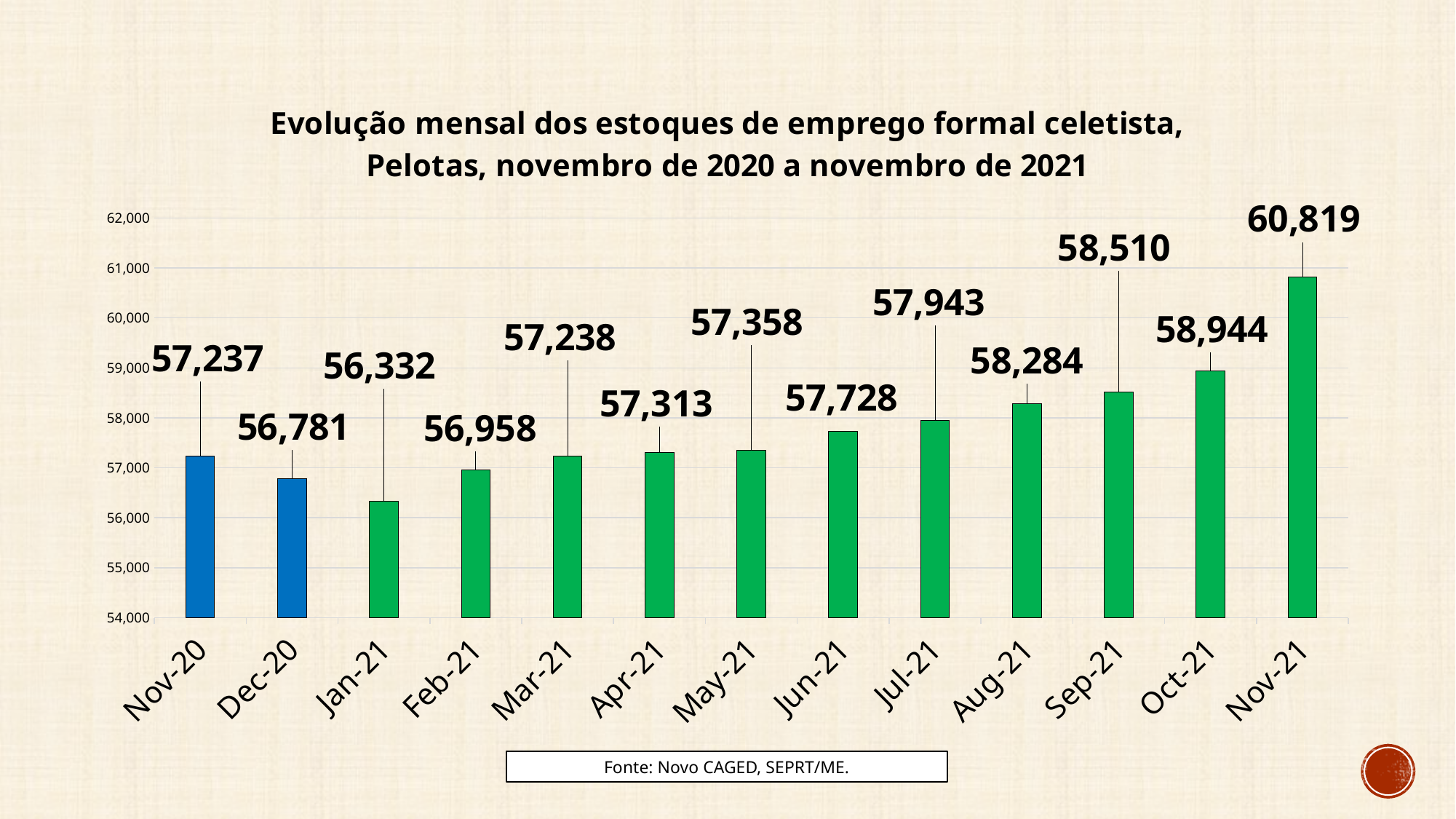
Which is larger, the value for Sep-21 or the value for Aug-21? Sep-21 How many months are shown on the x axis? 13 What is the value for Jun-21? 57,728 What is the value for Nov-21? 60,819 How many bars are coloured blue rather than green? 2 What kind of chart is shown on the slide? bar chart Which month has the lowest value? Jan-21 What is the difference between the values for Nov-21 and Oct-21? 1,875 Which month has the highest value? Nov-21 What is the difference between the values for Nov-21 and Nov-20? 3,582 Is the value for Nov-21 greater or less than 60,000? greater What is the value for Jan-21? 56,332